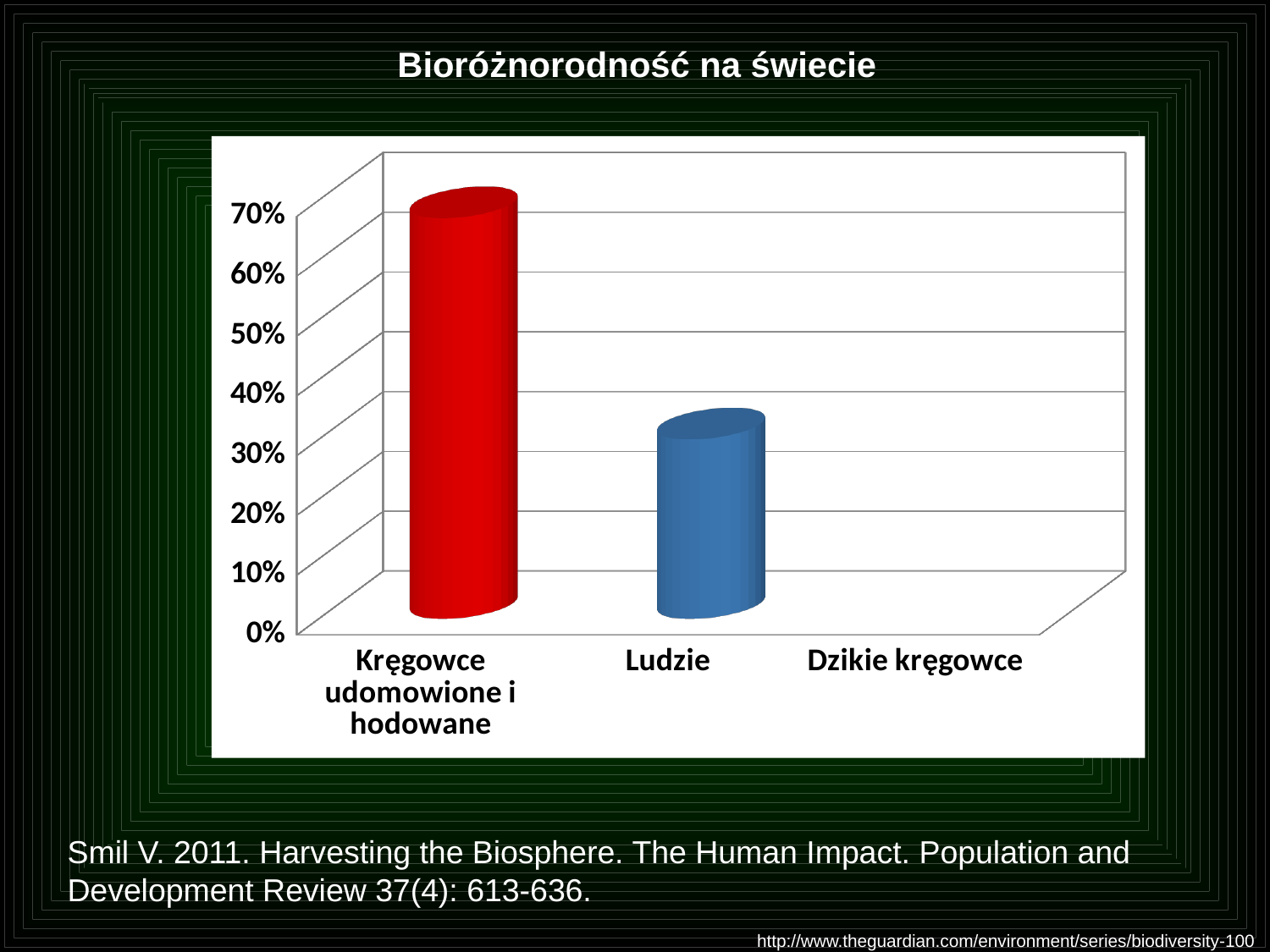
What is the title of the chart? Bioróżnorodność na świecie Which category has the highest value in the chart? Kręgowce udomowione i hodowane Which is larger, the value for Kręgowce udomowione i hodowane or the value for Ludzie? Kręgowce udomowione i hodowane Is the value for Kręgowce udomowione i hodowane greater or less than 60%? greater Is the value for Ludzie greater or less than 20%? greater Is the value for Dzikie kręgowce greater or less than 10%? less Which category has the lowest value in the chart? Dzikie kręgowce What kind of chart is shown on the slide? bar chart Do the values rise or fall from left to right along the x axis? fall How many categories are shown on the x axis of the chart? 3 What colour is the bar for Ludzie? blue